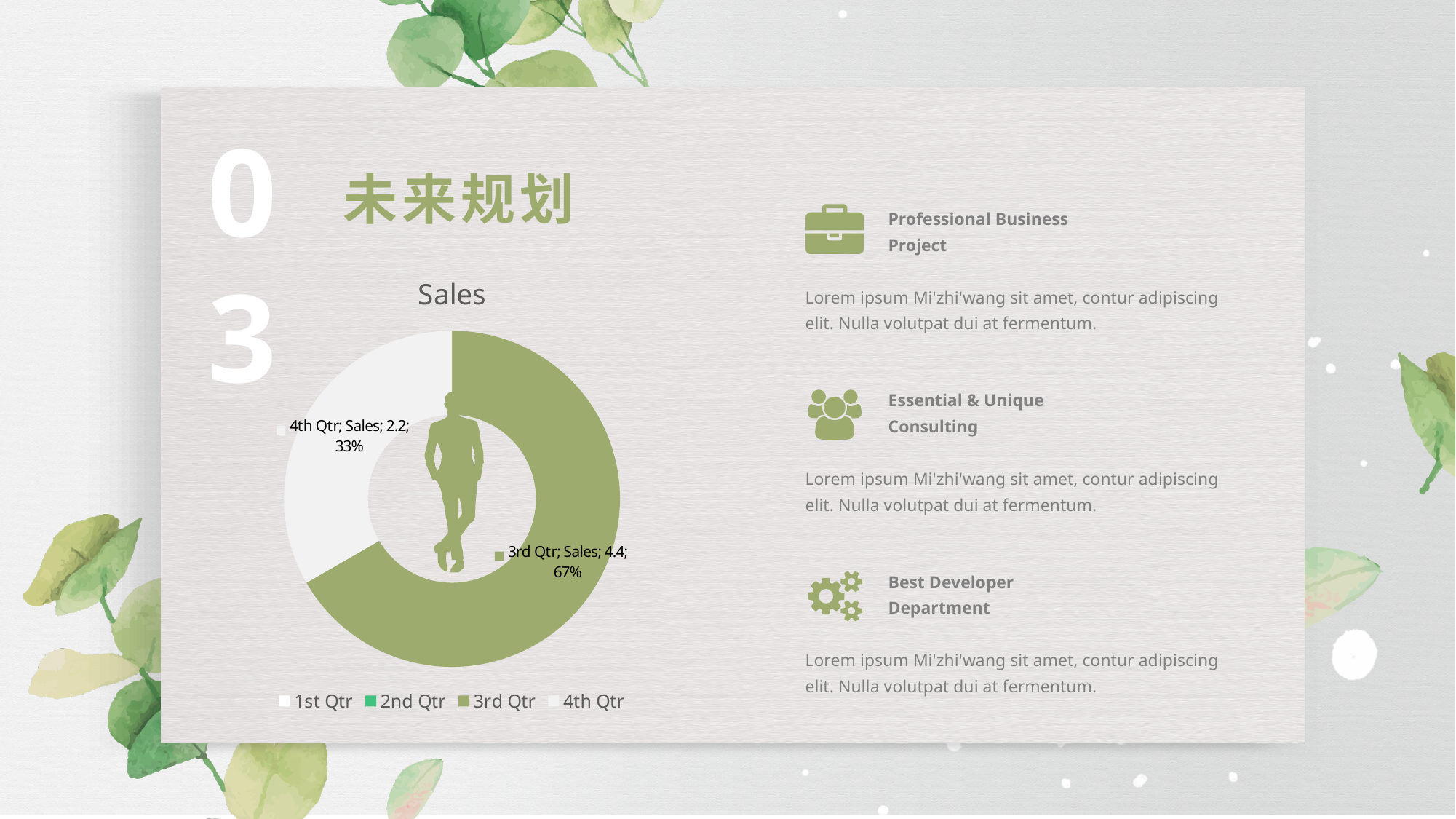
Which quarter has the largest slice in the chart? 3rd Qtr What is the title of the chart? Sales What is the difference between the 3rd Qtr and 4th Qtr Sales values? 2.2 What is the Sales value for 4th Qtr? 2.2 Which of the labelled slices is the smallest? 4th Qtr How many slices with data labels are shown in the chart? 2 What share of the chart does 3rd Qtr represent? 67% How many entries does the chart legend list? 4 What kind of chart is shown on the slide? doughnut chart What share of the chart does 4th Qtr represent? 33% Which is larger, the Sales value for 3rd Qtr or for 4th Qtr? 3rd Qtr What is the Sales value for 3rd Qtr? 4.4